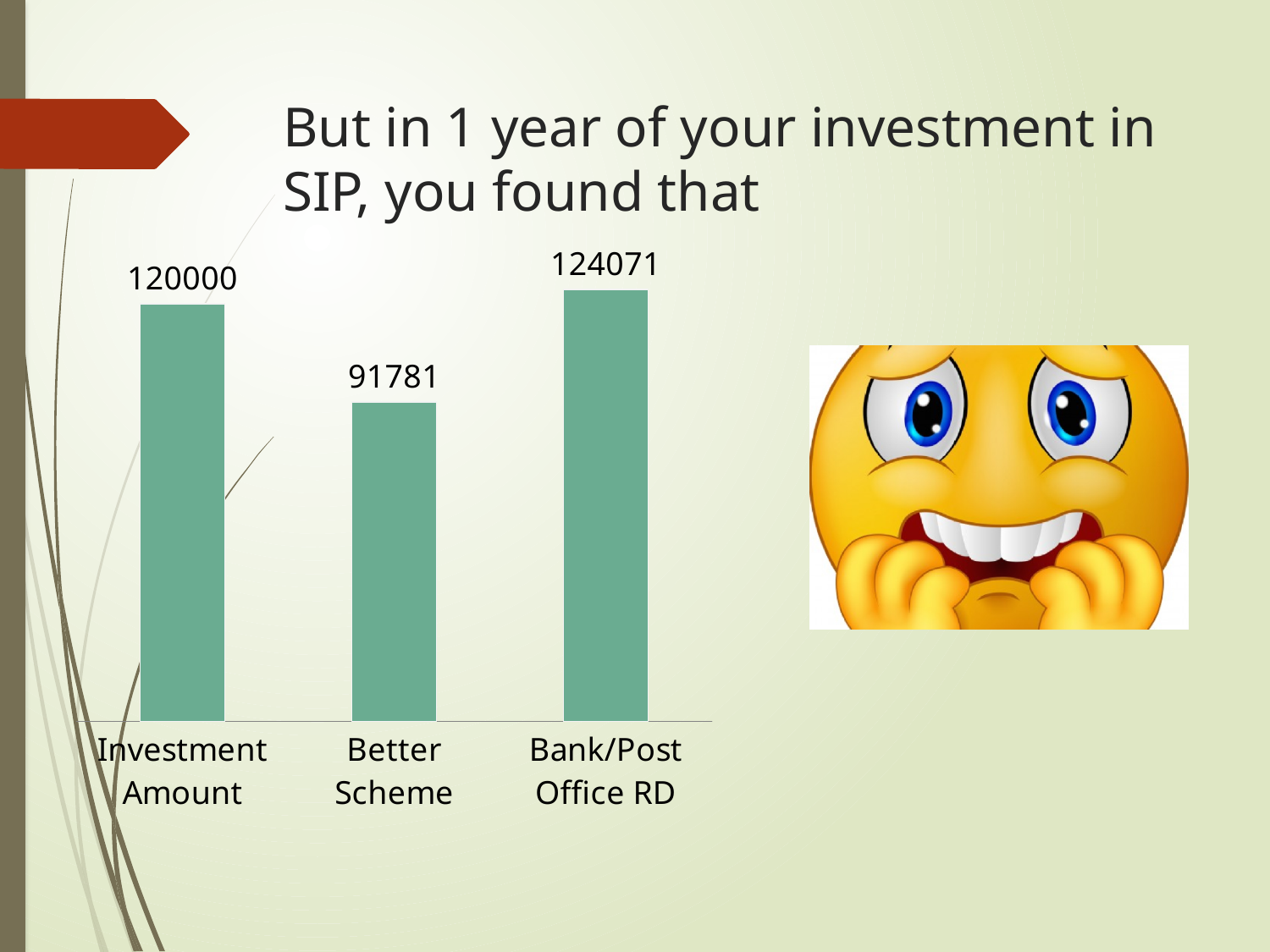
What kind of chart is shown on the slide? Bar chart What is the title of the slide containing the chart? But in 1 year of your investment in SIP, you found that Which is larger, the value for Better Scheme or the value for Bank/Post Office RD? Bank/Post Office RD Which category has the highest value? Bank/Post Office RD What is the value for Bank/Post Office RD? 124071 What colour are the bars in the chart? Green What is the value for Investment Amount? 120000 What is the value for Better Scheme? 91781 What is the difference between the values for Bank/Post Office RD and Investment Amount? 4071 What is the difference between the values for Investment Amount and Better Scheme? 28219 Which category has the lowest value? Better Scheme How many categories are shown in the chart? 3